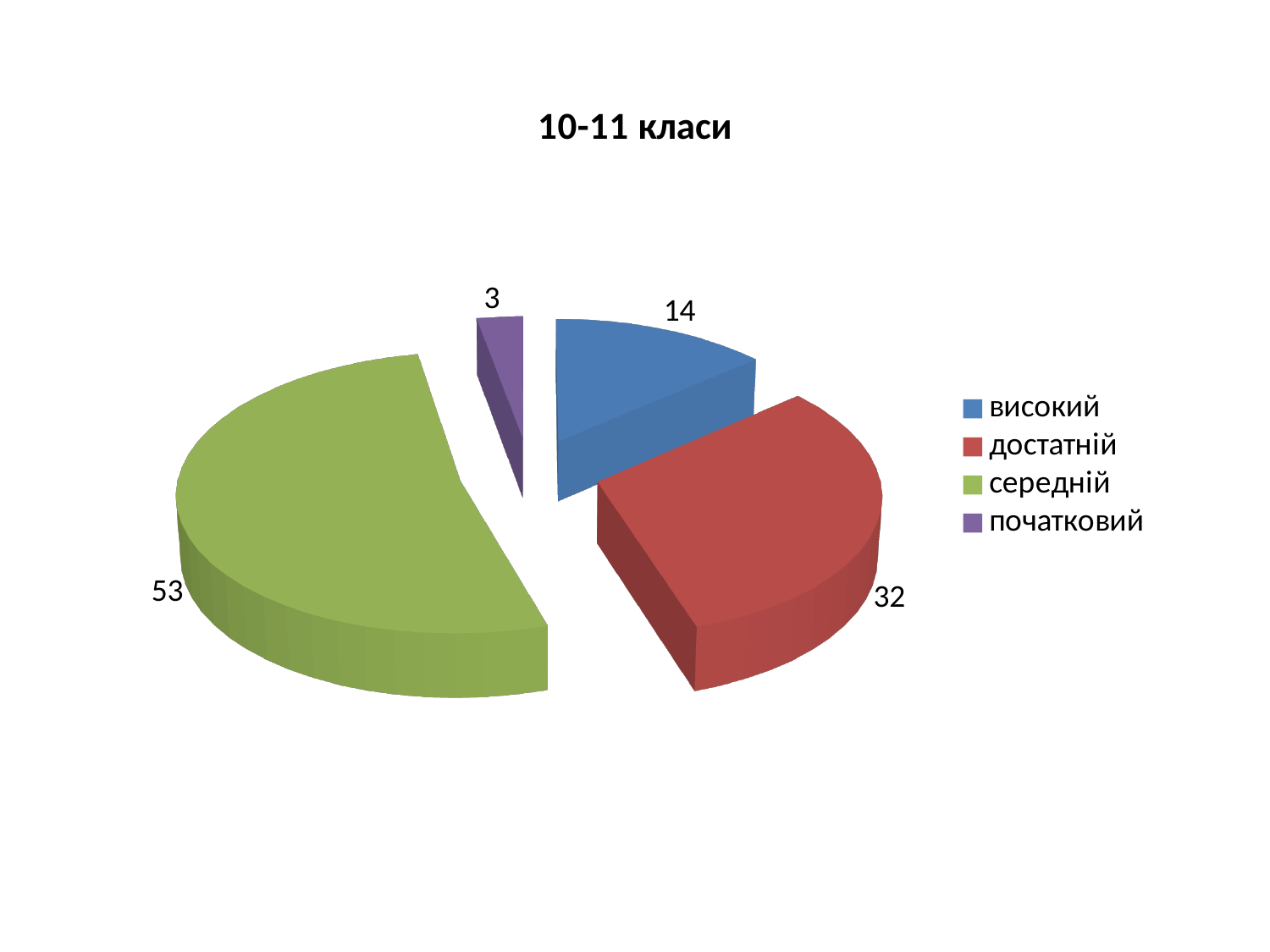
What is the value for the "середній" slice? 53 Which is larger, the value for "високий" or the value for "достатній"? достатній What is the difference between the values for "середній" and "достатній"? 21 What colour is the "середній" slice? green What type of chart is shown on the slide? pie chart Which category has the largest slice? середній What is the value for the "високий" slice? 14 How many slices does the pie chart have? 4 What is the value for the "достатній" slice? 32 Which category has the smallest slice? початковий What is the value for the "початковий" slice? 3 What is the title of the chart? 10-11 класи